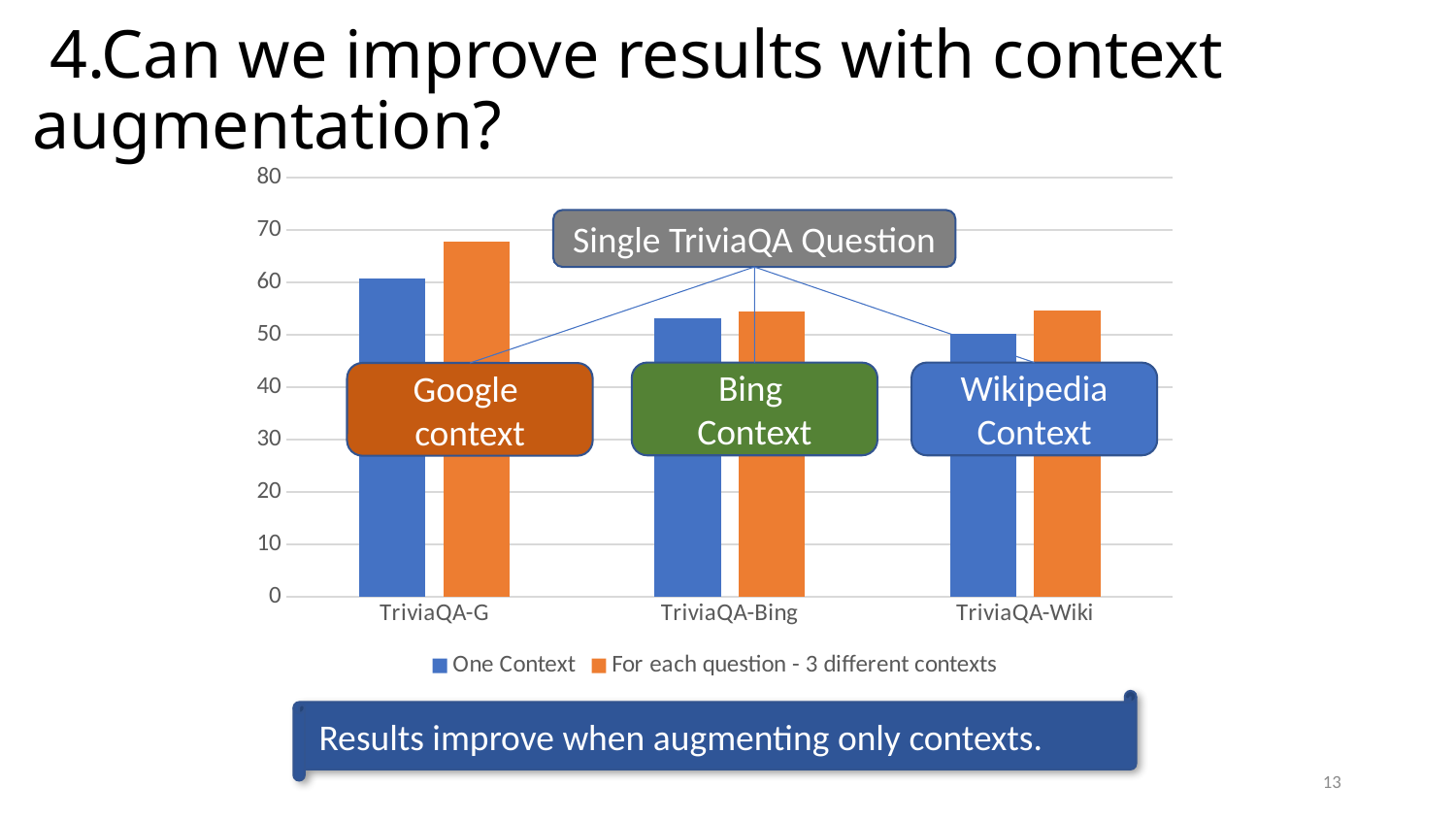
Is the One Context value for TriviaQA-Wiki greater or less than 40? greater How many categories are shown on the x axis of the chart? 3 What kind of chart is shown on the slide? bar chart Which category has the highest value for the 'For each question - 3 different contexts' series? TriviaQA-G How many series does the chart's legend list? 2 For TriviaQA-G, which is larger: One Context or 'For each question - 3 different contexts'? For each question - 3 different contexts For TriviaQA-Wiki, which is larger: One Context or 'For each question - 3 different contexts'? For each question - 3 different contexts Is the 'For each question - 3 different contexts' value for TriviaQA-G greater or less than 60? greater What colour are the bars for the One Context series? blue Is the One Context value for TriviaQA-G greater or less than 50? greater Which category has the highest value for the One Context series? TriviaQA-G